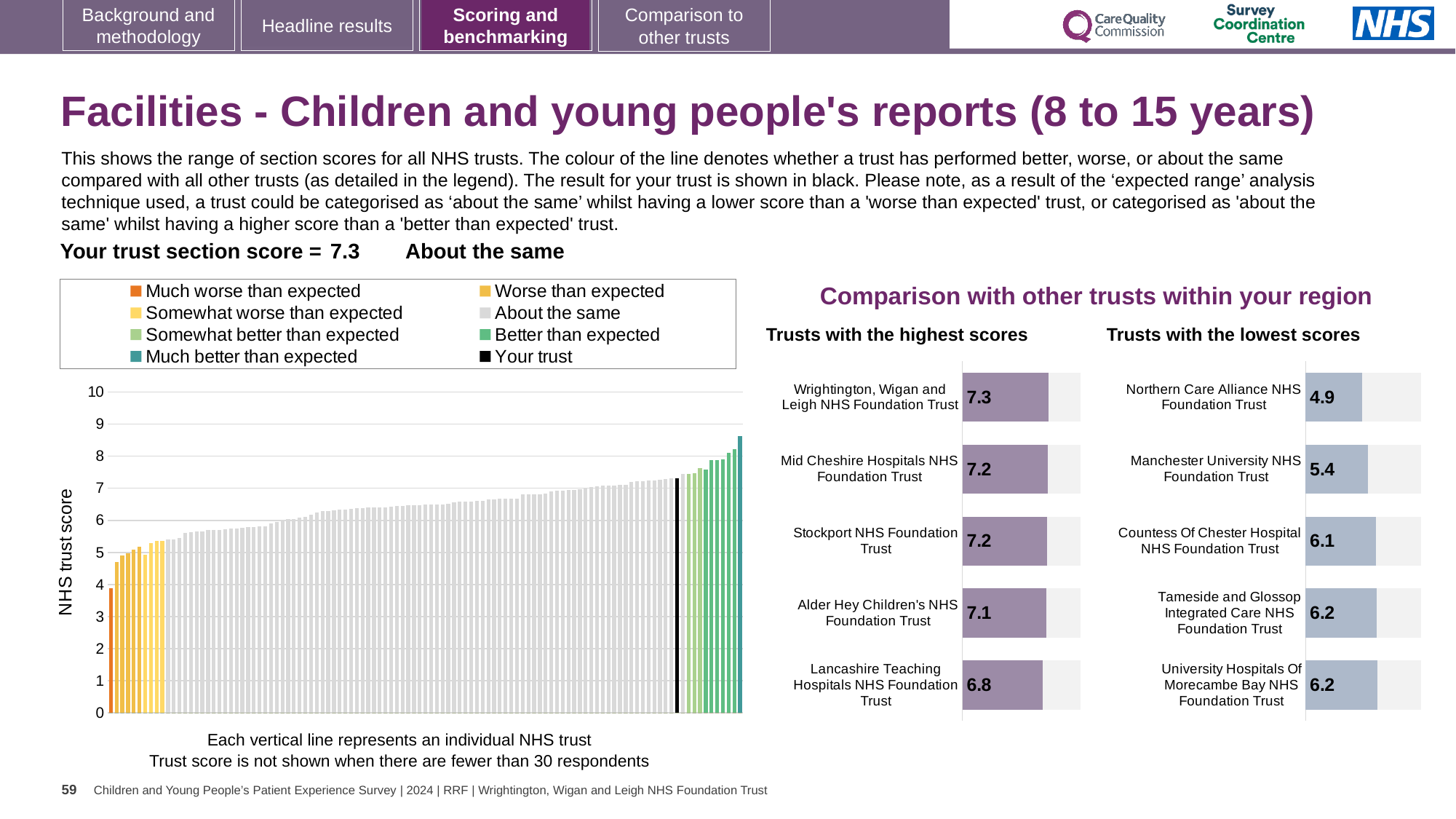
In the 'NHS trust score' chart, is the value of the tallest bar at the far right greater or less than 8? greater What kind of chart is the large chart on the left with the y axis labelled 'NHS trust score'? bar chart In the 'Trusts with the highest scores' chart, what is the difference between the scores of Wrightington, Wigan and Leigh NHS Foundation Trust and Lancashire Teaching Hospitals NHS Foundation Trust? 0.5 In the 'Trusts with the lowest scores' chart, what is the score for Northern Care Alliance NHS Foundation Trust? 4.9 In the 'Trusts with the highest scores' chart, how many trusts are shown? 5 In the 'Trusts with the lowest scores' chart, which has the larger score: Manchester University NHS Foundation Trust or Countess Of Chester Hospital NHS Foundation Trust? Countess Of Chester Hospital NHS Foundation Trust How many entries does the legend above the 'NHS trust score' chart list? 8 In the 'Trusts with the highest scores' chart, what is the score for Wrightington, Wigan and Leigh NHS Foundation Trust? 7.3 In the 'Trusts with the highest scores' chart, which trust has the lowest score? Lancashire Teaching Hospitals NHS Foundation Trust In the 'NHS trust score' chart, do the bar values rise or fall from left to right? rise In the 'NHS trust score' chart, is the value of the black bar (Your trust) greater or less than 7? greater In the 'Trusts with the lowest scores' chart, which trust has the lowest score? Northern Care Alliance NHS Foundation Trust